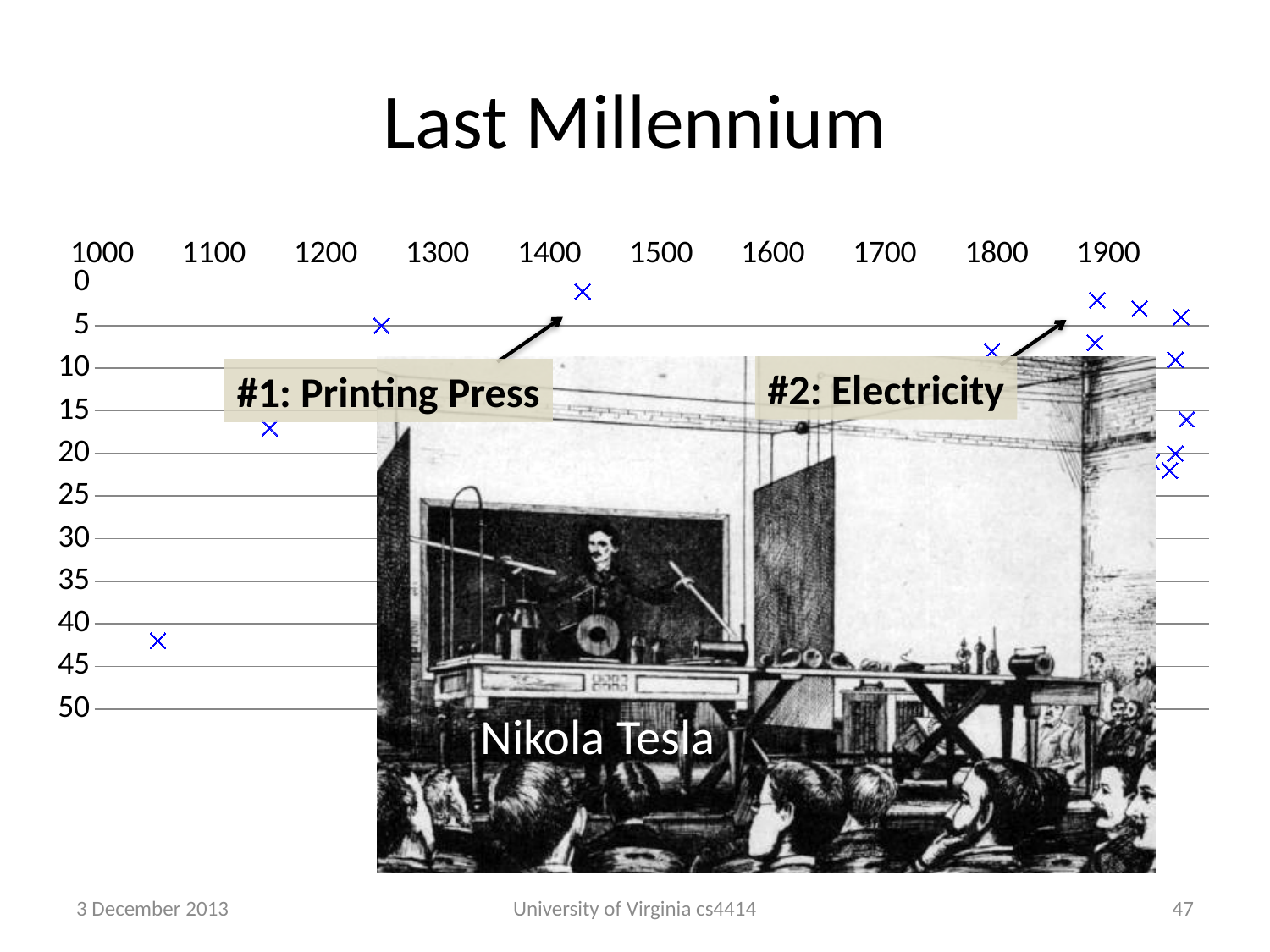
Is the y value of the data point near the year 1050 greater or less than 40? greater What are the two annotation labels pointing at data points on the chart? #1: Printing Press and #2: Electricity Is the y value of the data point labelled '#2: Electricity' (near 1880) greater or less than 5? less Is the y value of the data point near the year 1150 greater or less than 10? greater What is the title of the chart on the slide? Last Millennium What kind of chart is shown on the slide? scatter chart Which data point has the larger y value: the one near the year 1150 or the one labelled '#1: Printing Press'? the one near 1150 Which data point has the larger y value: the one near the year 1050 or the one near the year 1250? the one near 1050